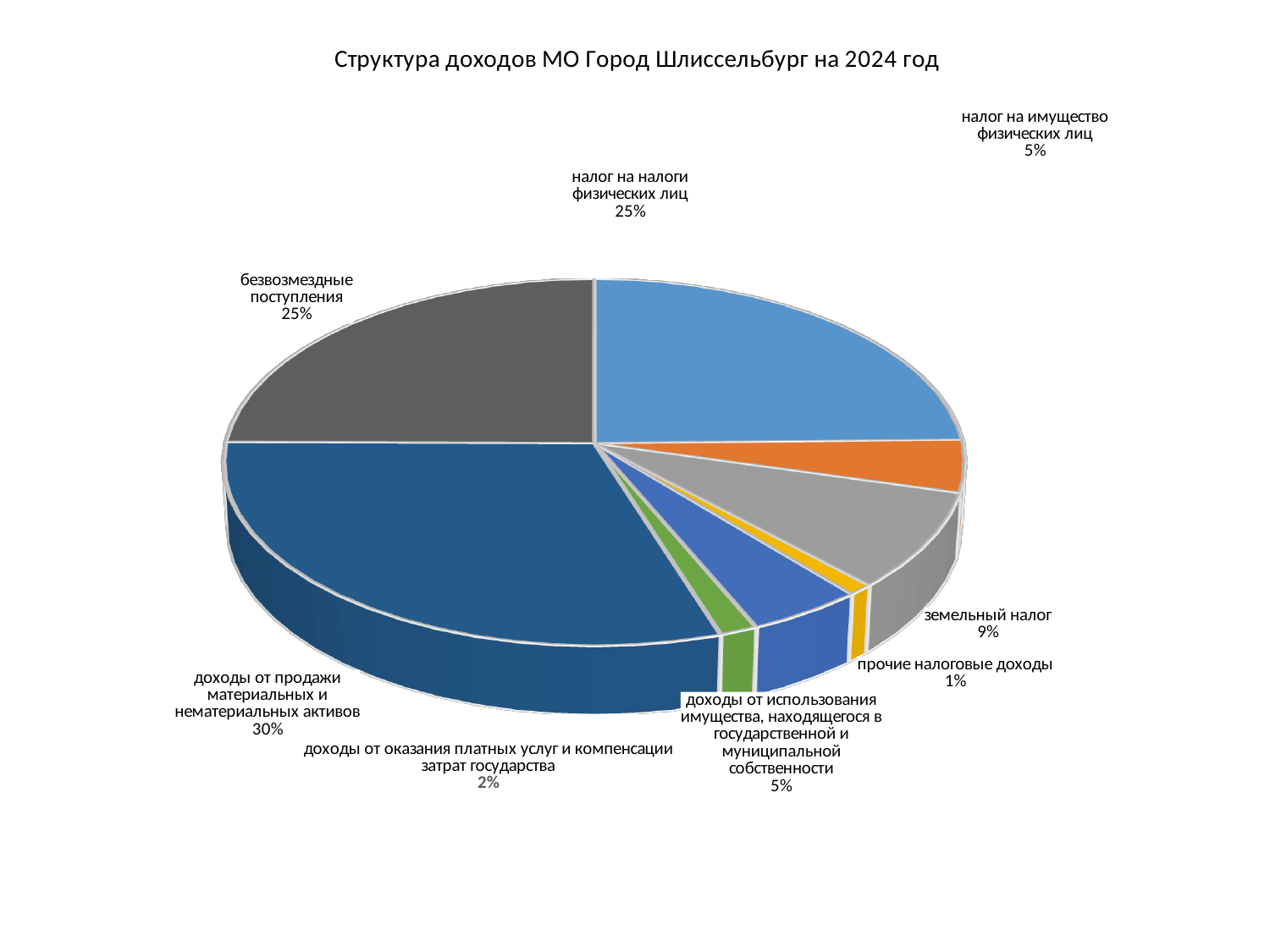
What share of the pie is labelled for "доходы от оказания платных услуг и компенсации затрат государства"? 2% What kind of chart is shown on the slide? pie chart How many slices does the pie chart have? 8 What share of the pie is labelled for "прочие налоговые доходы"? 1% What share of the pie is labelled for "безвозмездные поступления"? 25% Which is larger: the share for "земельный налог" or the share for "налог на имущество физических лиц"? земельный налог What is the title of the chart? Структура доходов МО Город Шлиссельбург на 2024 год What is the difference in percentage points between "доходы от продажи материальных и нематериальных активов" and "земельный налог"? 21 Which category has the smallest share of the pie? прочие налоговые доходы Which category has the largest share of the pie? доходы от продажи материальных и нематериальных активов